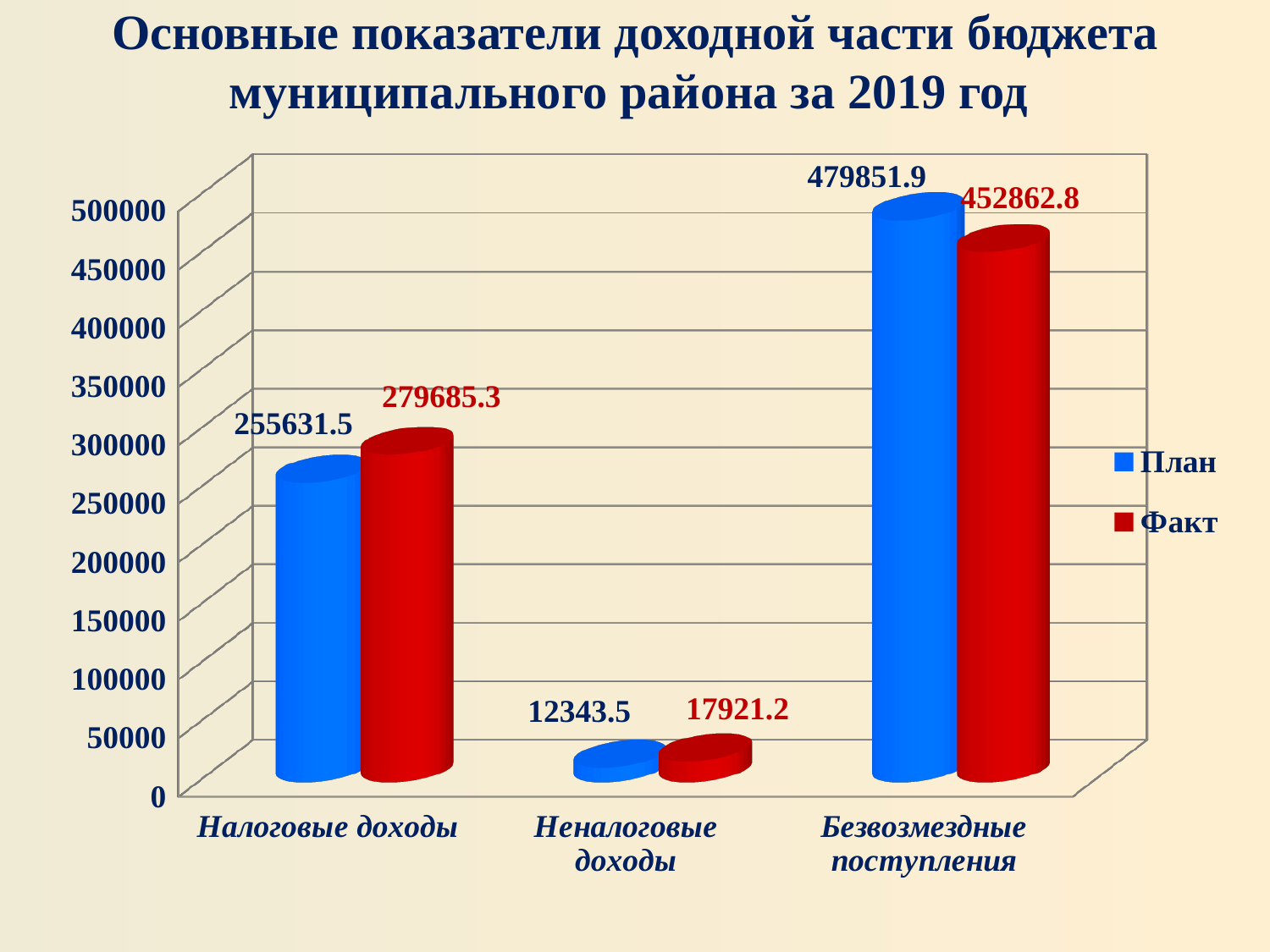
What is the План value for Налоговые доходы? 255631.5 What is the Факт value for Безвозмездные поступления? 452862.8 What is the Факт value for Неналоговые доходы? 17921.2 Which category has the highest План value? Безвозмездные поступления What kind of chart is shown on the slide? Bar chart What is the difference between the План and Факт values for Безвозмездные поступления? 26989.1 For Неналоговые доходы, which is larger: План or Факт? Факт How many categories are shown on the x axis? 3 For Безвозмездные поступления, which is larger: План or Факт? План How many series does the legend list? 2 What is the difference between the Факт and План values for Налоговые доходы? 24053.8 Which category has the lowest Факт value? Неналоговые доходы